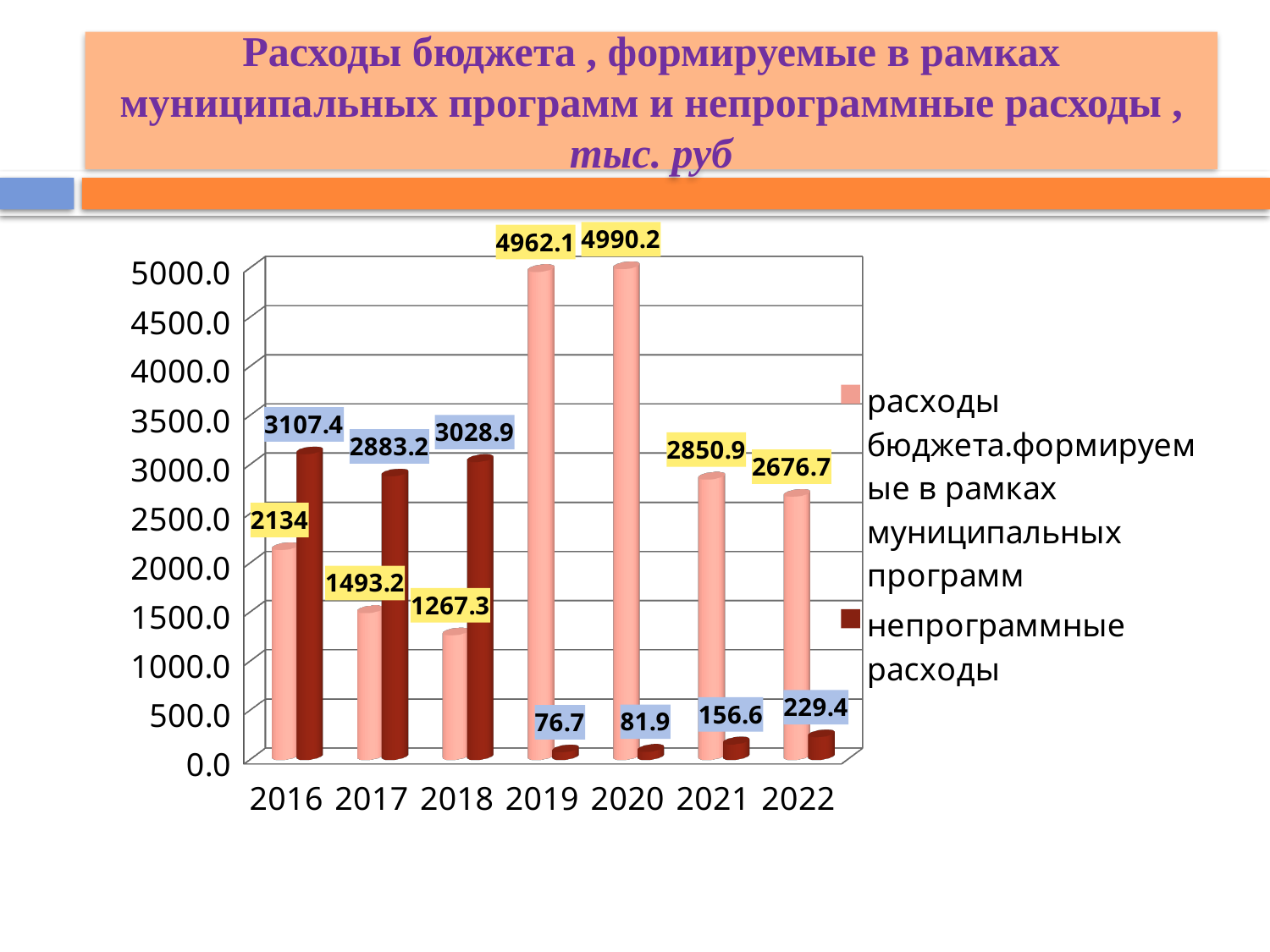
Is the value of расходы бюджета, формируемые в рамках муниципальных программ for 2021 greater or less than 2500? greater What is the total of расходы бюджета, формируемые в рамках муниципальных программ and непрограммные расходы for 2020? 5072.1 In which year is the value of непрограммные расходы the lowest? 2019 What is the value of непрограммные расходы for 2016? 3107.4 Which is larger in 2018: расходы бюджета, формируемые в рамках муниципальных программ or непрограммные расходы? непрограммные расходы How many series does the legend list? 2 How many years are shown on the x axis? 7 What is the value of непрограммные расходы for 2022? 229.4 What kind of chart is shown on the slide? bar chart What is the difference between непрограммные расходы in 2016 and in 2017? 224.2 In which year is the value of расходы бюджета, формируемые в рамках муниципальных программ the highest? 2020 What is the value of расходы бюджета, формируемые в рамках муниципальных программ for 2019? 4962.1